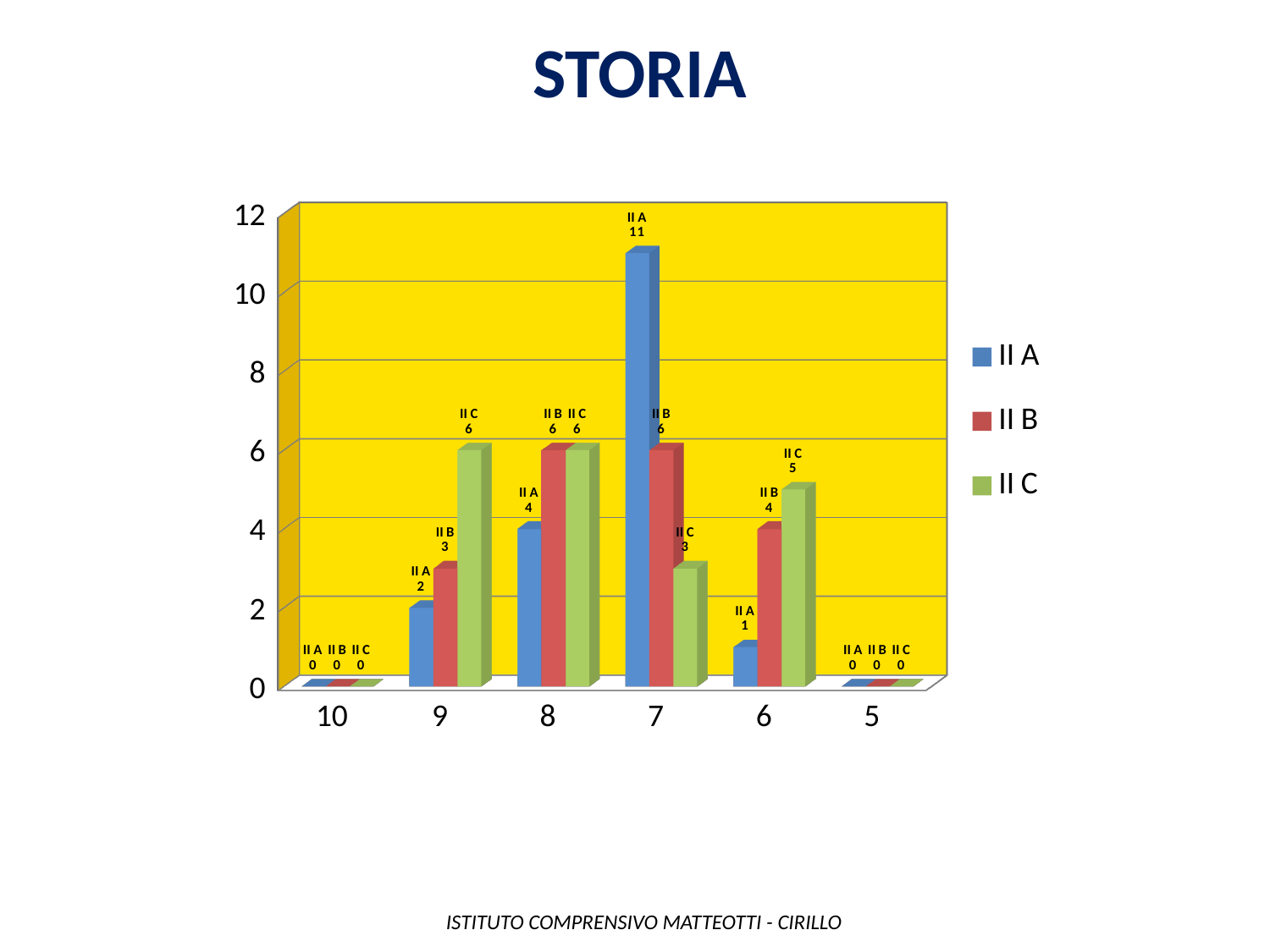
Which category has the highest value for II A? 7 What is the value for II A at category 7? 11 What is the total of II A, II B and II C at category 8? 16 What is the value for II B at category 6? 4 What is the value for II C at category 9? 6 How many series does the legend list? 3 How many categories are shown on the x axis? 6 Which category has the lowest value for II C among 9, 8, 7 and 6? 7 What kind of chart is shown? bar chart Which is larger at category 9: II B or II C? II C What is the difference between II A and II C at category 7? 8 What is the title of the chart? STORIA